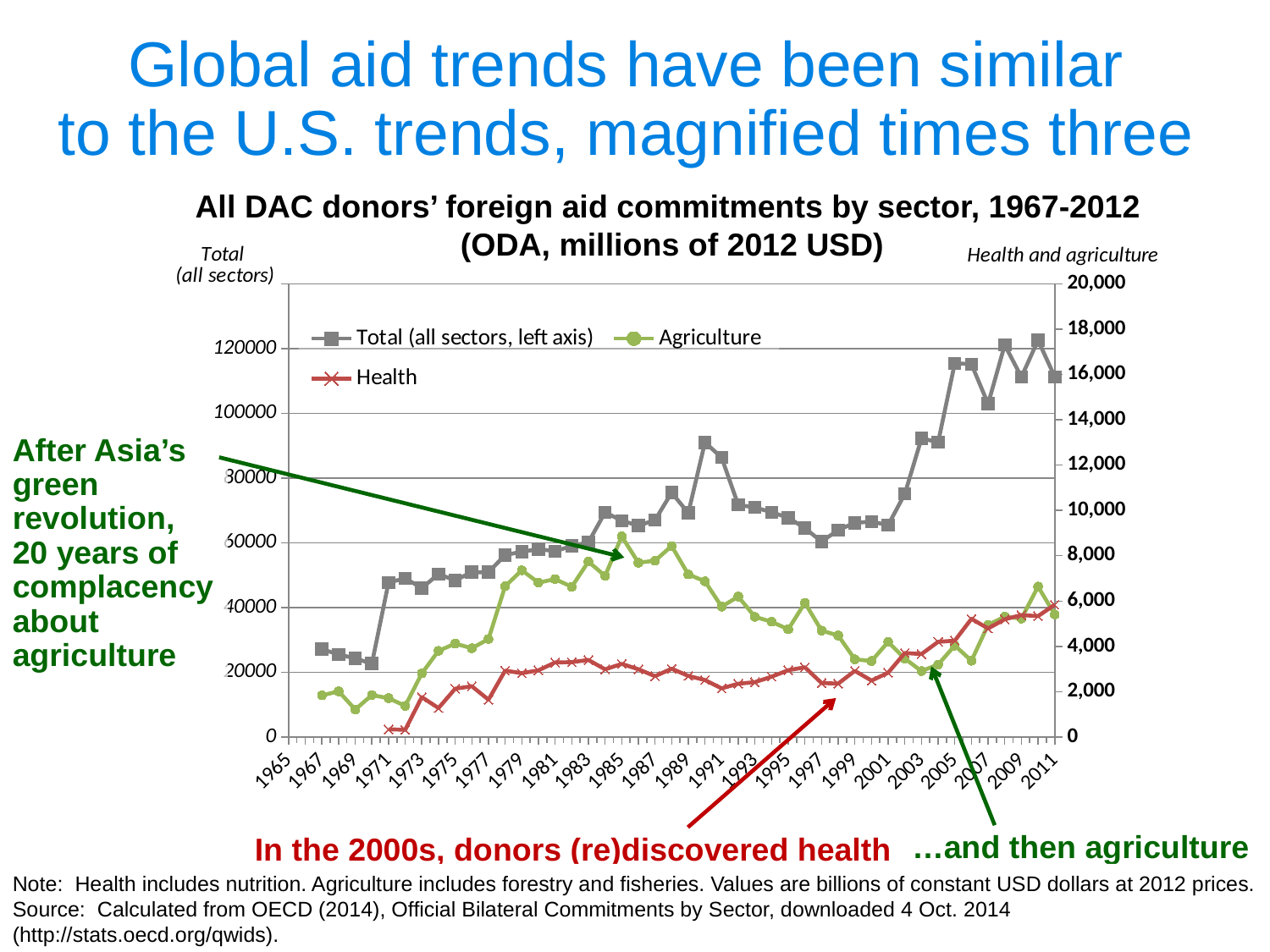
In 1985, which is larger, the Agriculture value or the Health value? Agriculture Is the Total (all sectors) value for 1971 greater or less than 40000? greater Is the Health value for 1971 greater or less than 2,000? less Is the Health value for 2011 greater or less than 4,000? greater Which series in the chart is plotted against the left axis? Total (all sectors, left axis) What is the title of the chart? All DAC donors' foreign aid commitments by sector, 1967-2012 (ODA, millions of 2012 USD) What kind of chart is shown on the slide? line chart Does the Agriculture series rise or fall between 1989 and 2003? fall How many series does the chart's legend list? 3